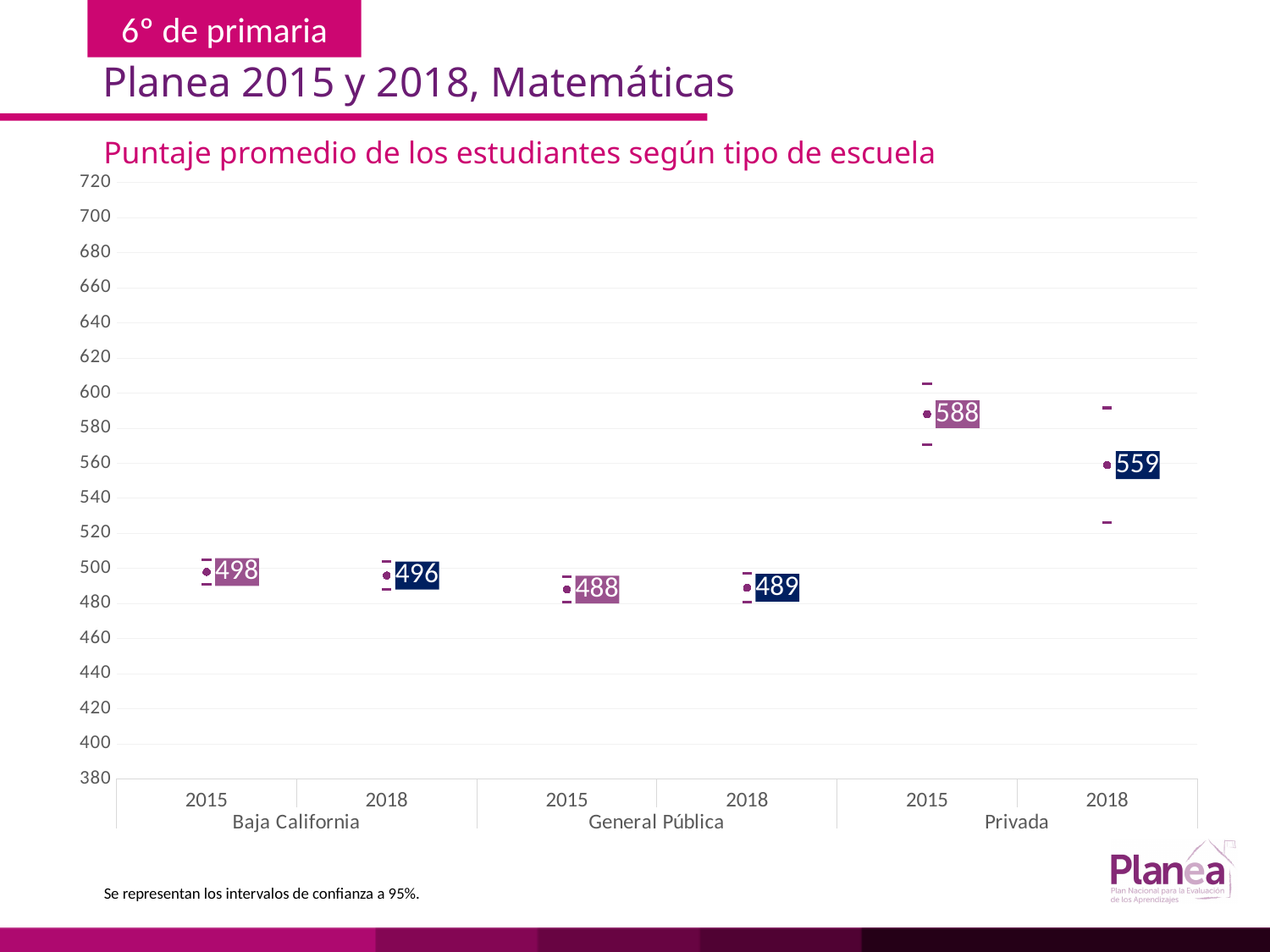
How many data points are plotted on the chart? 6 Which is larger, the Privada score in 2018 or the Baja California score in 2018? Privada 2018 Did the Privada average score rise or fall from 2015 to 2018? fall Which group and year has the lowest average score? General Pública 2015 What is the average score for General Pública schools in 2015? 488 What is the difference between the Privada scores in 2015 and 2018? 29 What is the average score for Privada schools in 2018? 559 What is the difference between the Baja California score in 2015 and the General Pública score in 2015? 10 What is the title of the chart? Puntaje promedio de los estudiantes según tipo de escuela Which group and year has the highest average score? Privada 2015 What is the average score for Privada schools in 2015? 588 What is the average score for Baja California in 2018? 496